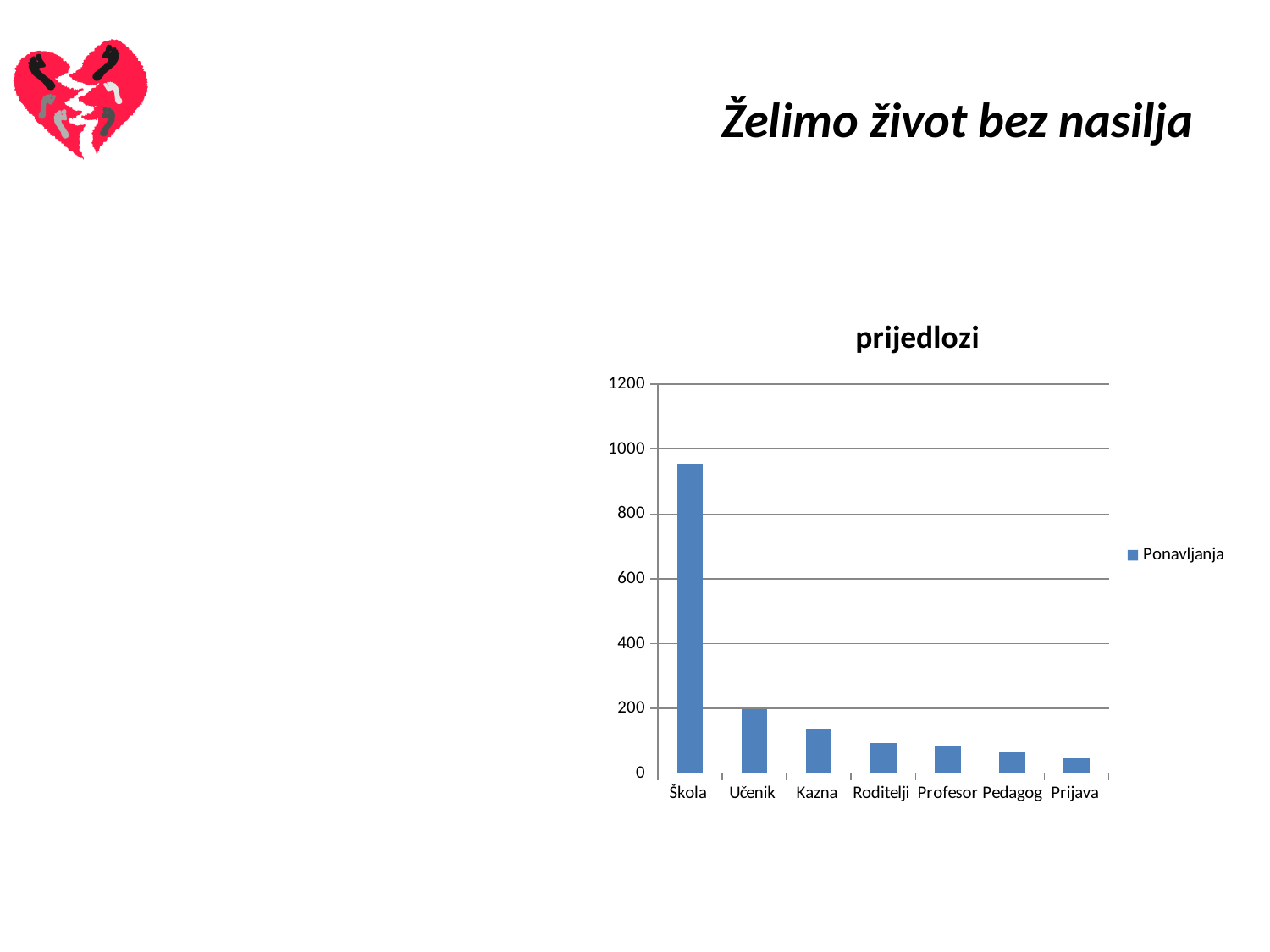
Which is larger, the value for Škola or the value for Učenik? Škola Is the value for Kazna greater or less than 200? less Which category has the highest value? Škola Do the values rise or fall from left to right along the x axis? fall What type of chart is shown on the slide? bar chart Is the value for Škola greater or less than 800? greater What is the name of the series shown in the legend? Ponavljanja Is the value for Učenik greater or less than 400? less Which category has the lowest value? Prijava How many series does the legend list? 1 How many categories are shown on the x axis? 7 What is the title of the chart? prijedlozi